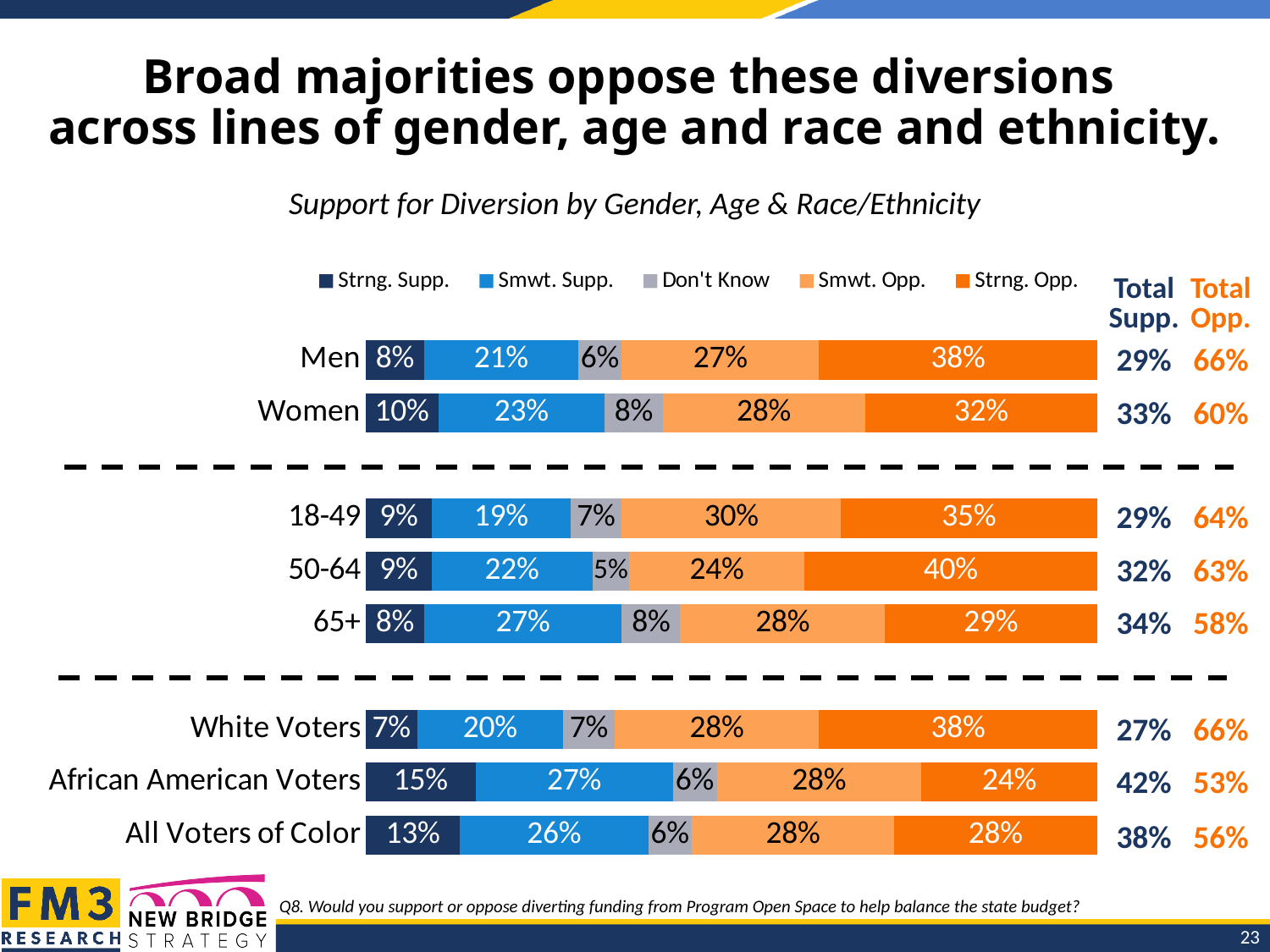
Which is larger, the Smwt. Supp. value for 65+ or for 18-49? 65+ What is the difference between the Strng. Opp. values for Men and Women? 6% What is the combined Strng. Supp. and Smwt. Supp. total for All Voters of Color? 38% Which category has the lowest Strng. Supp. value? White Voters How many series does the legend list? 5 What is the title of the chart? Support for Diversion by Gender, Age & Race/Ethnicity What percentage of Men strongly oppose the diversion? 38% How many categories (bars) are shown in the chart? 8 Which category has the highest Strng. Opp. value? 50-64 What is the Smwt. Supp. value for African American Voters? 27% What kind of chart is shown on the slide? Stacked bar chart What is the Don't Know value for the 50-64 age group? 5%